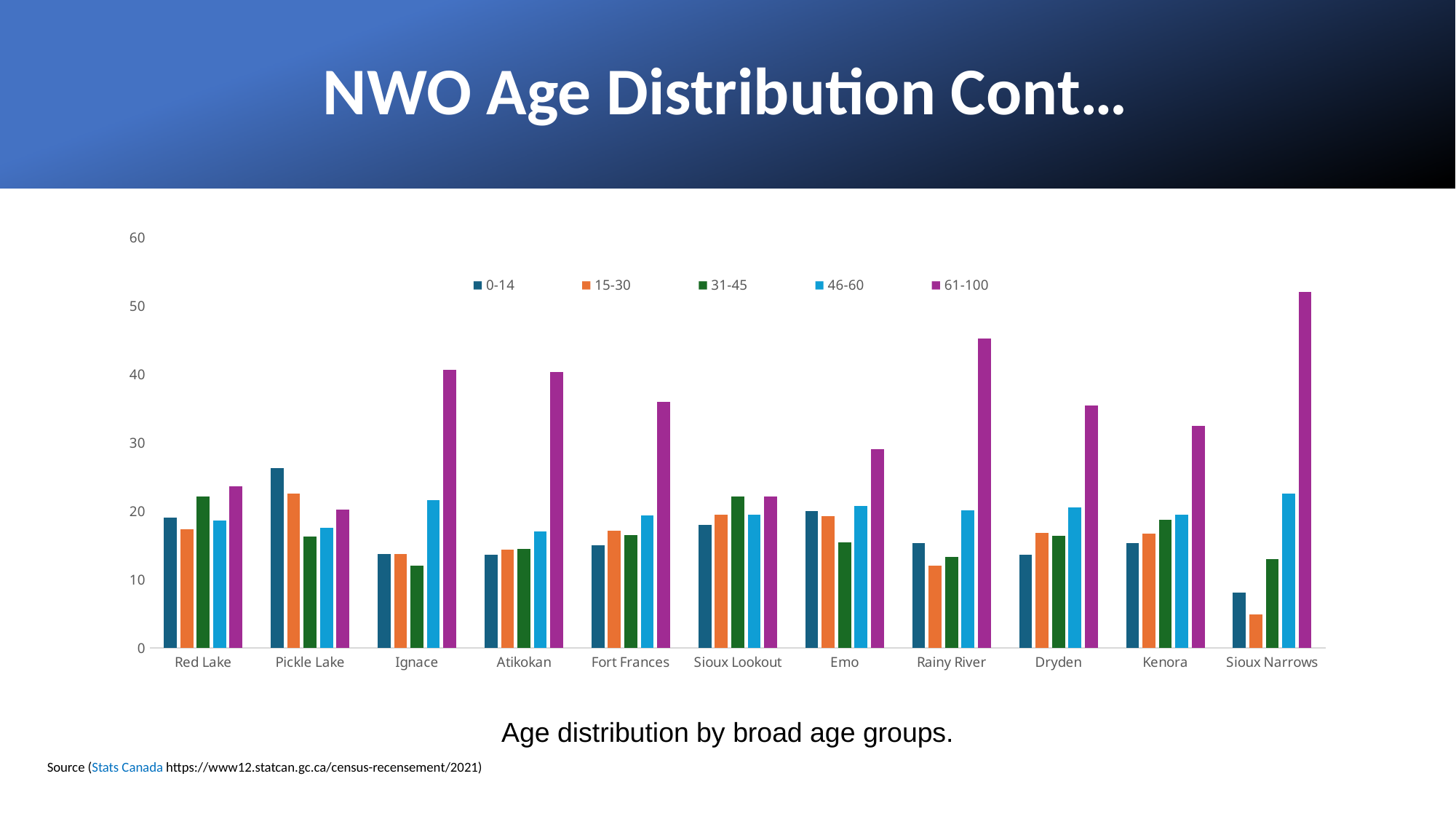
Which community has the highest value for the 0-14 age group? Pickle Lake Is the value for the 0-14 age group in Sioux Narrows greater or less than 10? less Is the value for the 61-100 age group in Sioux Narrows greater or less than 50? greater What caption appears below the chart? Age distribution by broad age groups. In Pickle Lake, which is larger: the 0-14 value or the 61-100 value? 0-14 Which community has the lowest value for the 15-30 age group? Sioux Narrows How many communities are shown along the x axis? 11 Is the value for the 61-100 age group in Rainy River greater or less than 40? greater How many age-group series does the legend list? 5 Which is larger: the 61-100 value for Ignace or the 61-100 value for Fort Frances? Ignace Which community has the highest value for the 61-100 age group? Sioux Narrows What kind of chart is shown on the slide? Bar chart